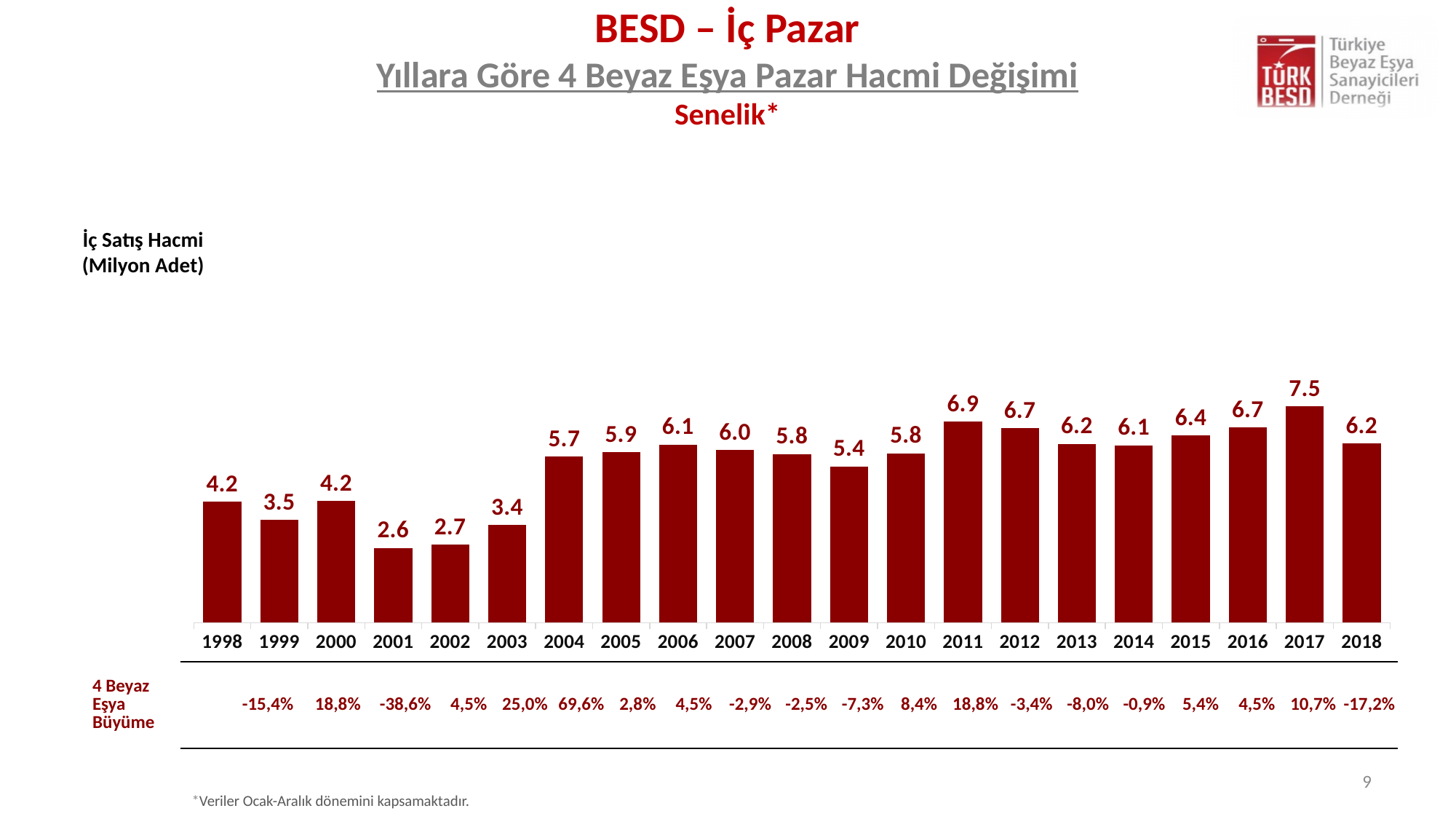
Which year has the lowest domestic sales volume? 2001 Which year has a larger value, 2011 or 2012? 2011 What is the domestic sales volume shown for 2001? 2.6 Which year has the highest domestic sales volume? 2017 What unit is given for the domestic sales volume axis label? Milyon Adet What kind of chart is shown on the slide? Bar chart What is the domestic sales volume (İç Satış Hacmi) for 2017? 7.5 How many years are shown on the x axis of the chart? 21 What is the value shown for 2018? 6.2 Do the values rise or fall from 2015 to 2017? Rise What is the difference between the 2017 value and the 2018 value? 1.3 What growth percentage (4 Beyaz Eşya Büyüme) is shown for 2004? 69,6%